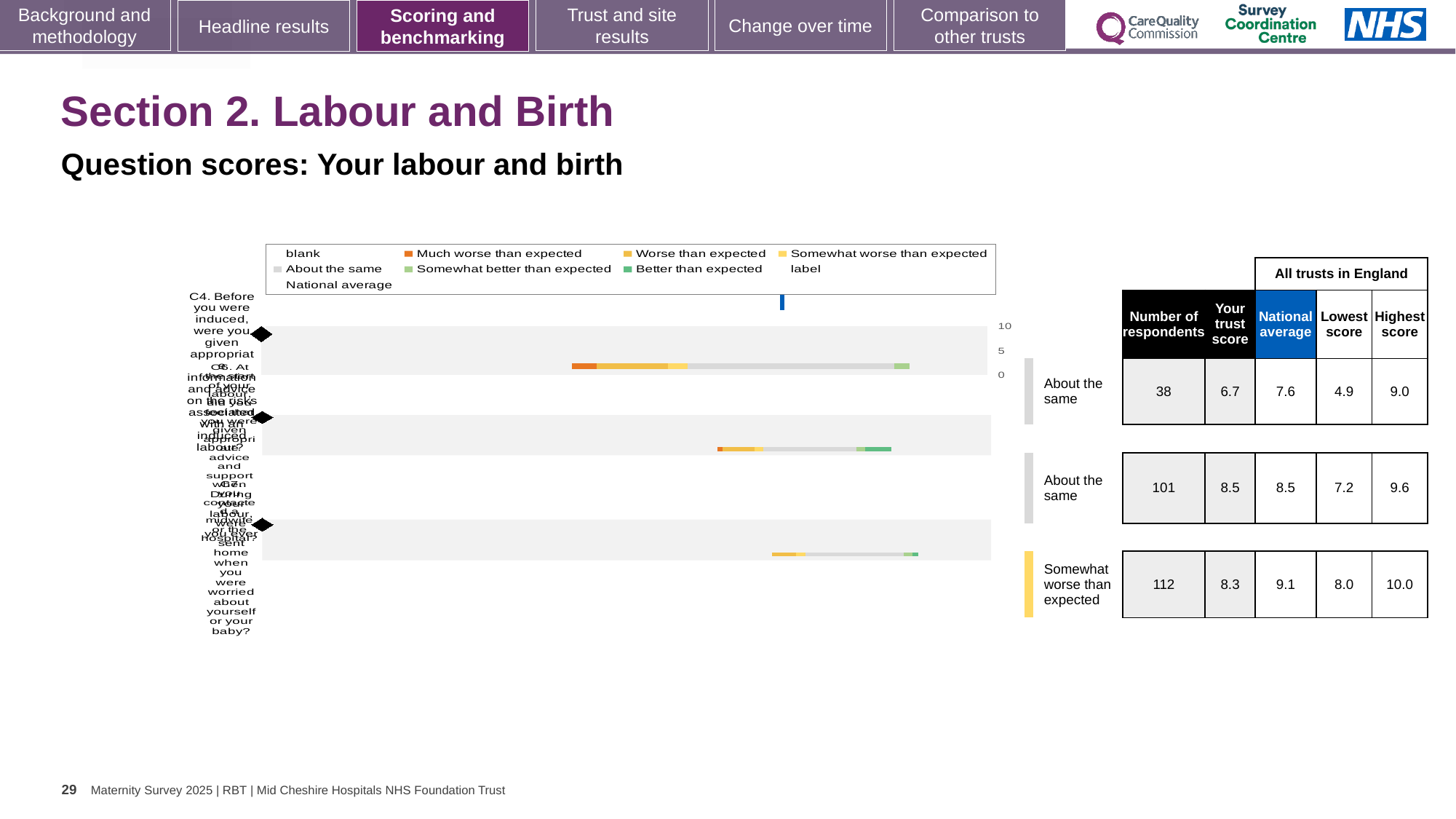
In the table beside the chart, what is the highest score in England for the bottom row? 10.0 In the table beside the chart, which row has the most respondents? the bottom row (112) In the chart legend, what colour represents 'Much worse than expected'? orange How many horizontal bars (survey questions) are plotted in the chart? 3 In the table beside the chart, what is the 'Your trust score' for the top row (question C4)? 6.7 In the table beside the chart, what is the national average for the bottom row? 9.1 In the chart legend, what colour represents 'Better than expected'? green In the table beside the chart, what is the difference between the national average and the trust score for the top row? 0.9 In the table beside the chart, what is the lowest score in England for the middle row? 7.2 In the table beside the chart, how many respondents are shown for the top row (question C4)? 38 What benchmark label is shown next to the bottom row of the chart? Somewhat worse than expected What kind of chart is shown on the slide? bar chart